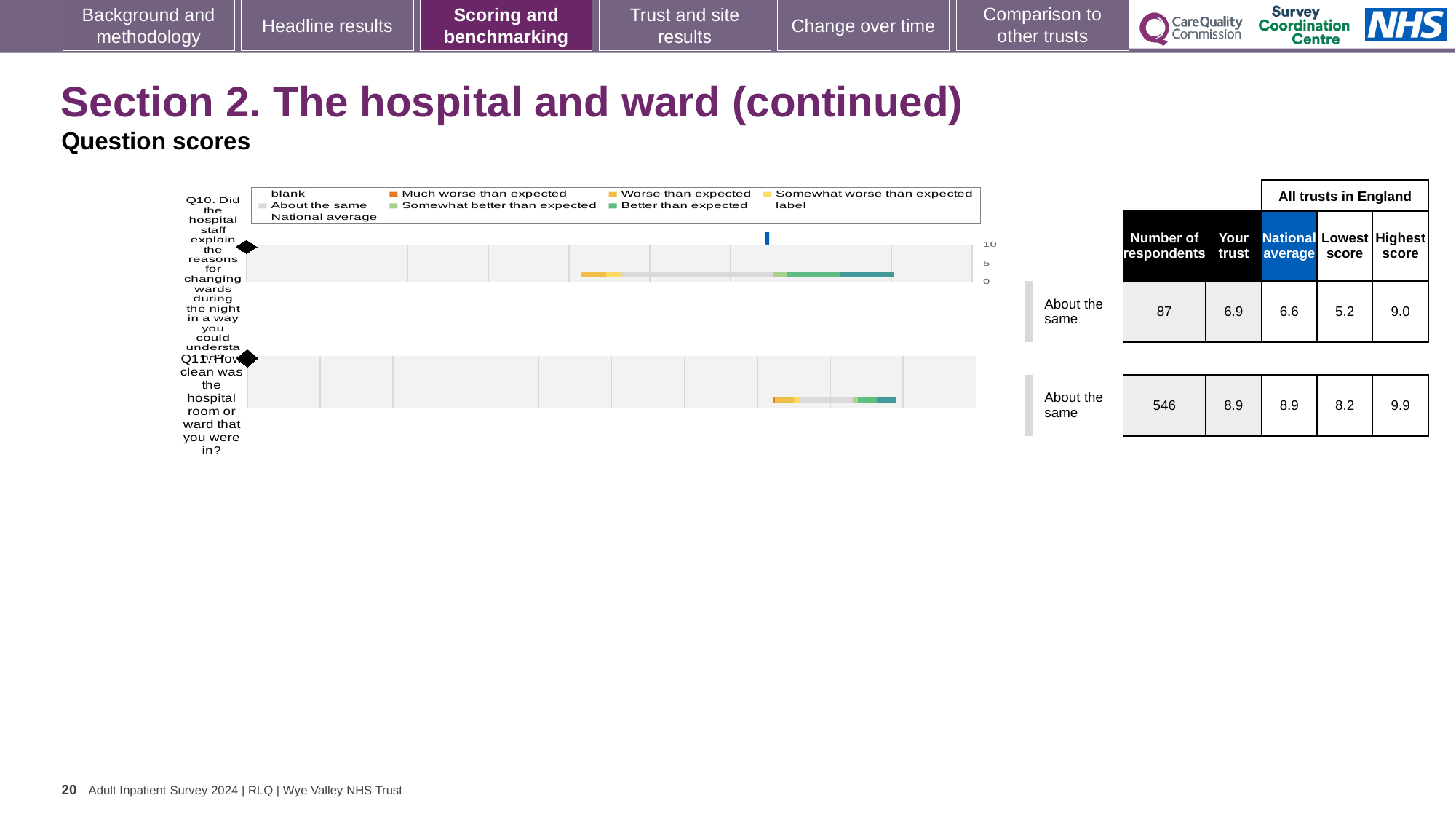
What is the highest score among all trusts in England for Q11? 9.9 What is the 'Your trust' score for Q10 (explaining reasons for changing wards during the night)? 6.9 How many questions (categories) are plotted in the question scores chart? 2 What kind of chart is used to show the question scores on this slide? bar chart What is the difference between the highest and lowest scores for Q10 across all trusts in England? 3.8 Is the trust's score for Q10 greater or less than 5 on the chart axis? greater For Q10, which is larger: the trust's own score or the national average? Your trust What is the 'Your trust' score for Q11 (how clean was the hospital room or ward)? 8.9 Which question has the higher 'Your trust' score, Q10 or Q11? Q11 What is the national average score for Q10? 6.6 How many respondents answered Q11? 546 Which benchmarking category is shown for both Q10 and Q11? About the same